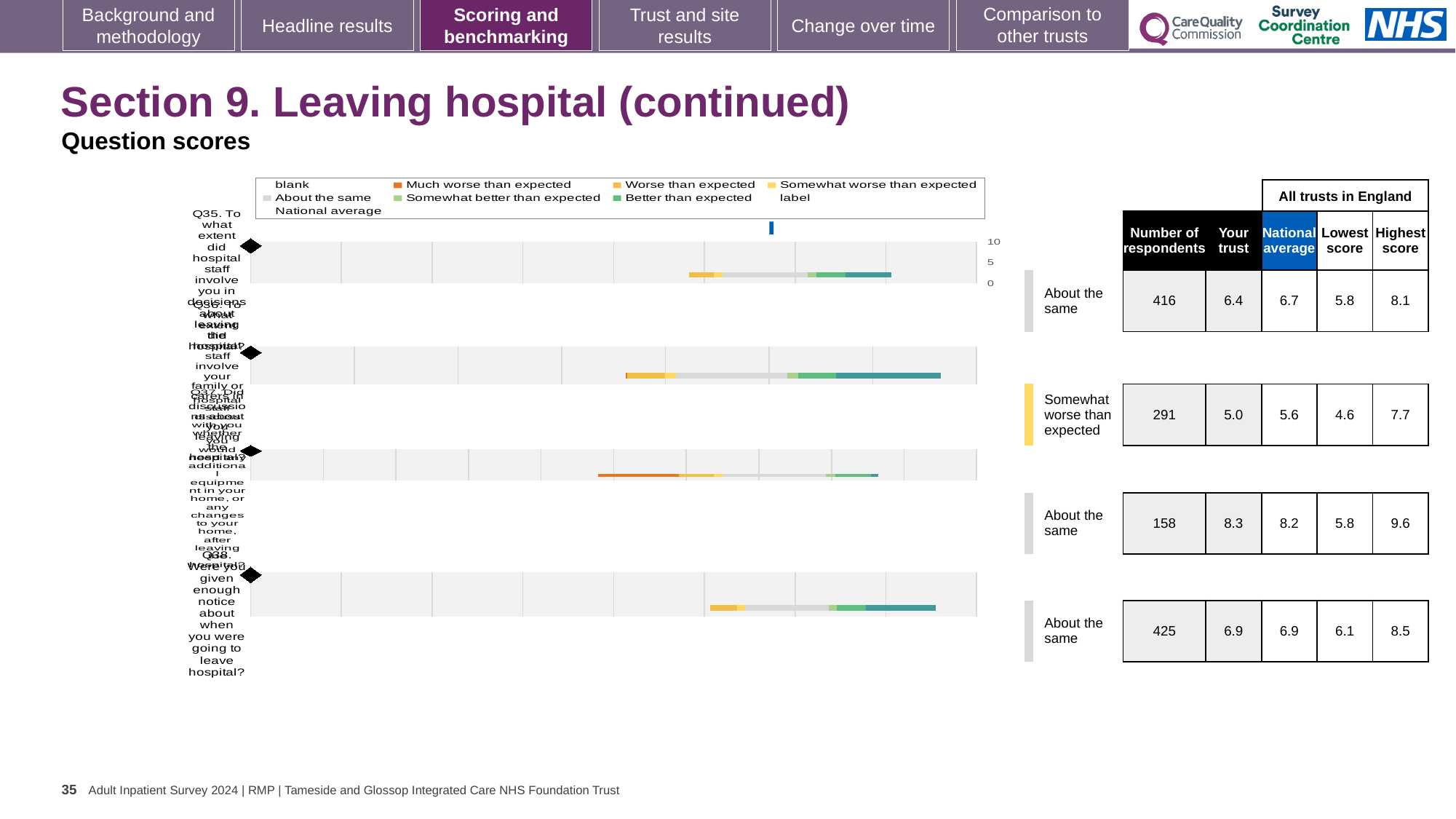
What is the 'Your trust' score for Q38 (Were you given enough notice about when you were going to leave hospital?)? 6.9 For Q35, which is larger: the 'Your trust' score or the national average? national average What is the national average score for Q35 (To what extent did hospital staff involve you in decisions about leaving the hospital?)? 6.7 What benchmark category is shown for the second question row (291 respondents)? Somewhat worse than expected What is the difference between the highest score and the lowest score for Q38? 2.4 What is the lowest score among all trusts in England for the second question row (291 respondents)? 4.6 What is the number of respondents for Q38 (Were you given enough notice about when you were going to leave hospital?)? 425 Which question row has the highest number of respondents? Q38 (Were you given enough notice about when you were going to leave hospital?) What kind of chart is shown on the slide? bar chart How many questions (rows) are plotted in the chart? 4 Which question row has the lowest number of respondents? the third row (158 respondents) What is the highest score among all trusts in England for the third question row (158 respondents)? 9.6